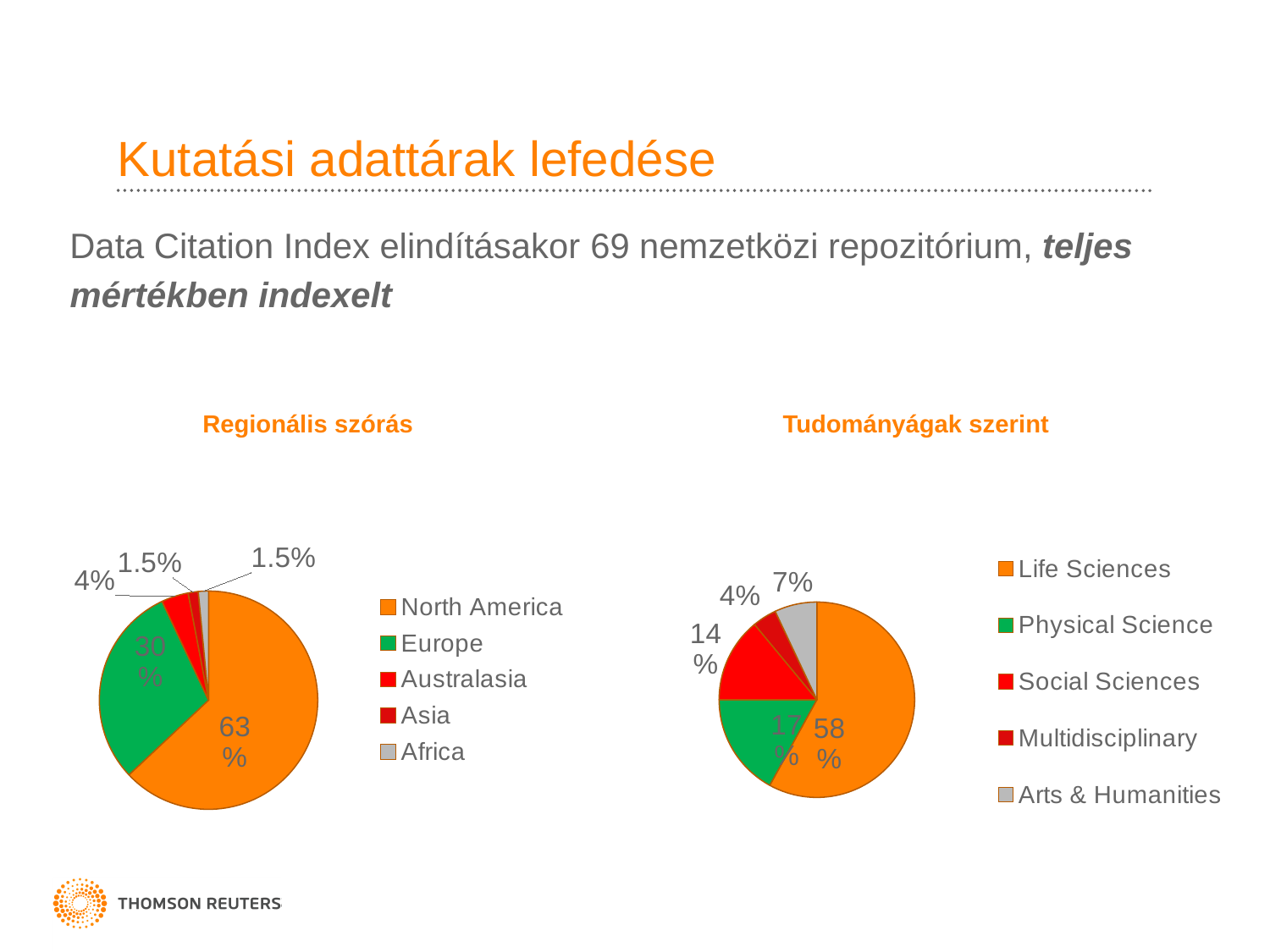
In the 'Tudományágak szerint' chart, which discipline has the smallest share? Multidisciplinary In the 'Tudományágak szerint' chart, how many categories does the legend list? 5 In the 'Tudományágak szerint' chart, which is larger, Physical Science or Social Sciences? Physical Science In the 'Regionális szórás' chart, which region has the largest share? North America In the 'Regionális szórás' chart, what is the difference between the North America and Europe shares? 33% What kind of chart is the 'Regionális szórás' chart? Pie chart In the 'Tudományágak szerint' chart, what share does Arts & Humanities have? 7% In the 'Regionális szórás' chart, how many regions does the legend list? 5 In the 'Regionális szórás' chart, what share does North America have? 63% In the 'Tudományágak szerint' chart, what share does Life Sciences have? 58% In the 'Regionális szórás' chart, what share does Europe have? 30% In the 'Tudományágak szerint' chart, what share does Social Sciences have? 14%